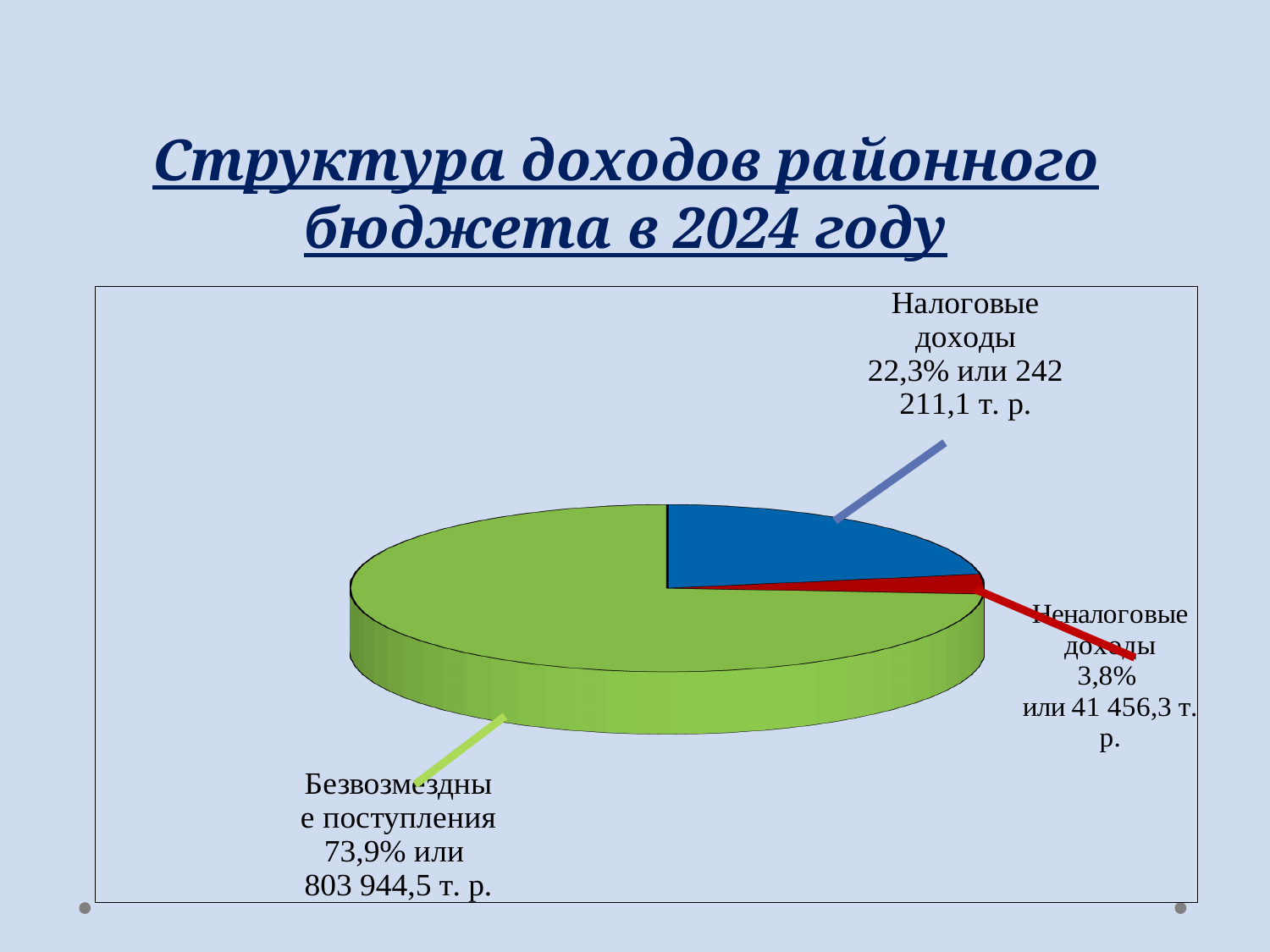
By how many percentage points does the share of Безвозмездные поступления exceed the share of Налоговые доходы? 51,6 Which category has the largest share of the pie? Безвозмездные поступления What share of the pie does Неналоговые доходы represent? 3,8% What share of the pie does Безвозмездные поступления represent? 73,9% Which category has the smallest share of the pie? Неналоговые доходы What is the amount shown for Неналоговые доходы? 41 456,3 т. р. What colour is the slice for Неналоговые доходы? Red How many slices does the pie chart have? 3 What share of the pie does Налоговые доходы represent? 22,3% What is the amount shown for Налоговые доходы? 242 211,1 т. р. What is the amount shown for Безвозмездные поступления? 803 944,5 т. р. What kind of chart is shown on the slide? Pie chart